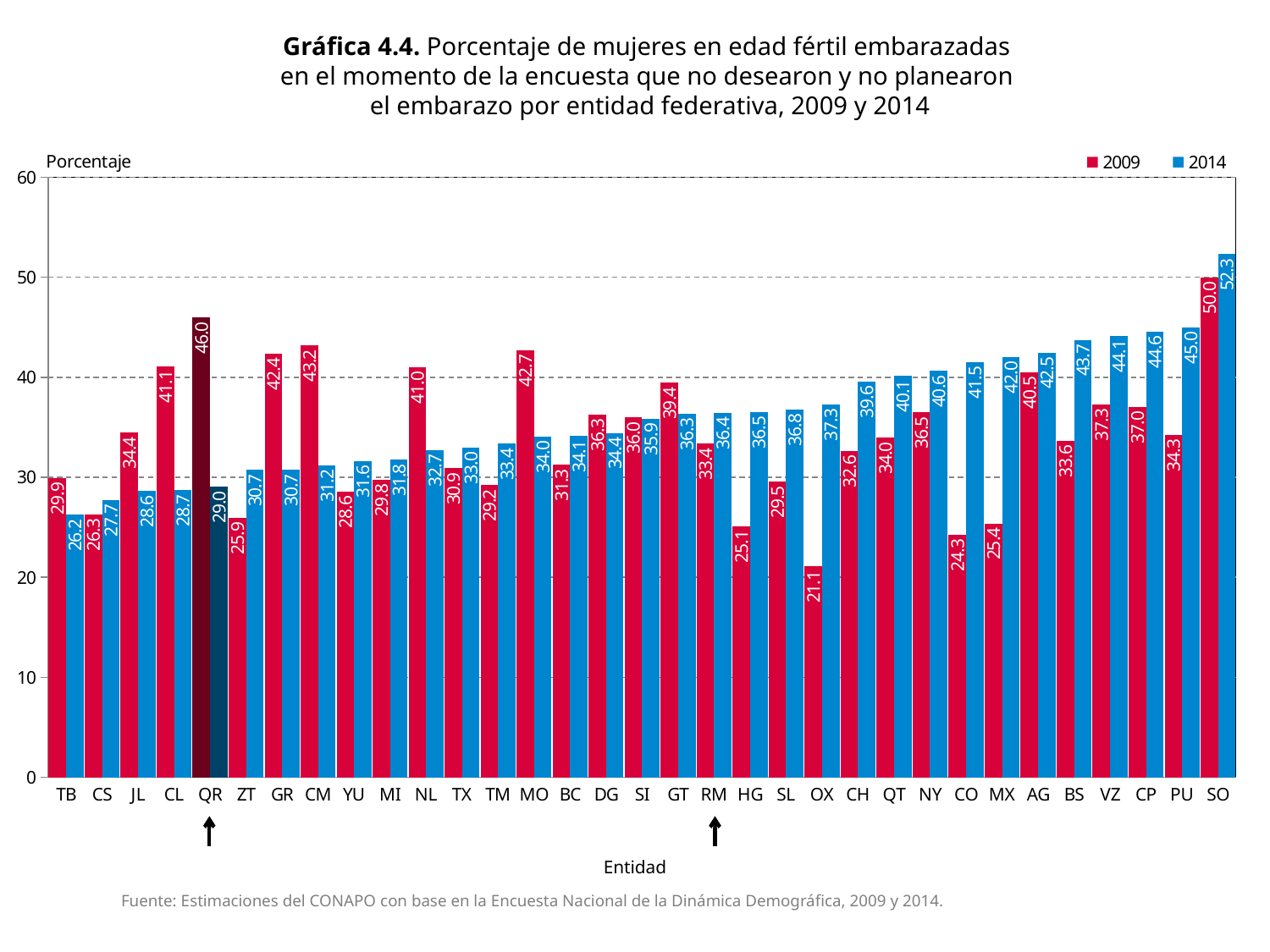
Which is larger for CL, the 2009 value or the 2014 value? 2009 What is the difference between the 2014 and 2009 values for SO? 2.3 How many series does the legend list? 2 How many entities are shown on the x axis? 33 Do the 2014 values rise or fall from left to right along the x axis? Rise What is the 2009 value for QR? 46.0 What is the 2014 value for RM? 36.4 What is the 2009 value for OX? 21.1 Which entity has the lowest 2009 value? OX What kind of chart is shown? Bar chart Which entity has the highest 2014 value? SO Which entity has the lowest 2014 value? TB